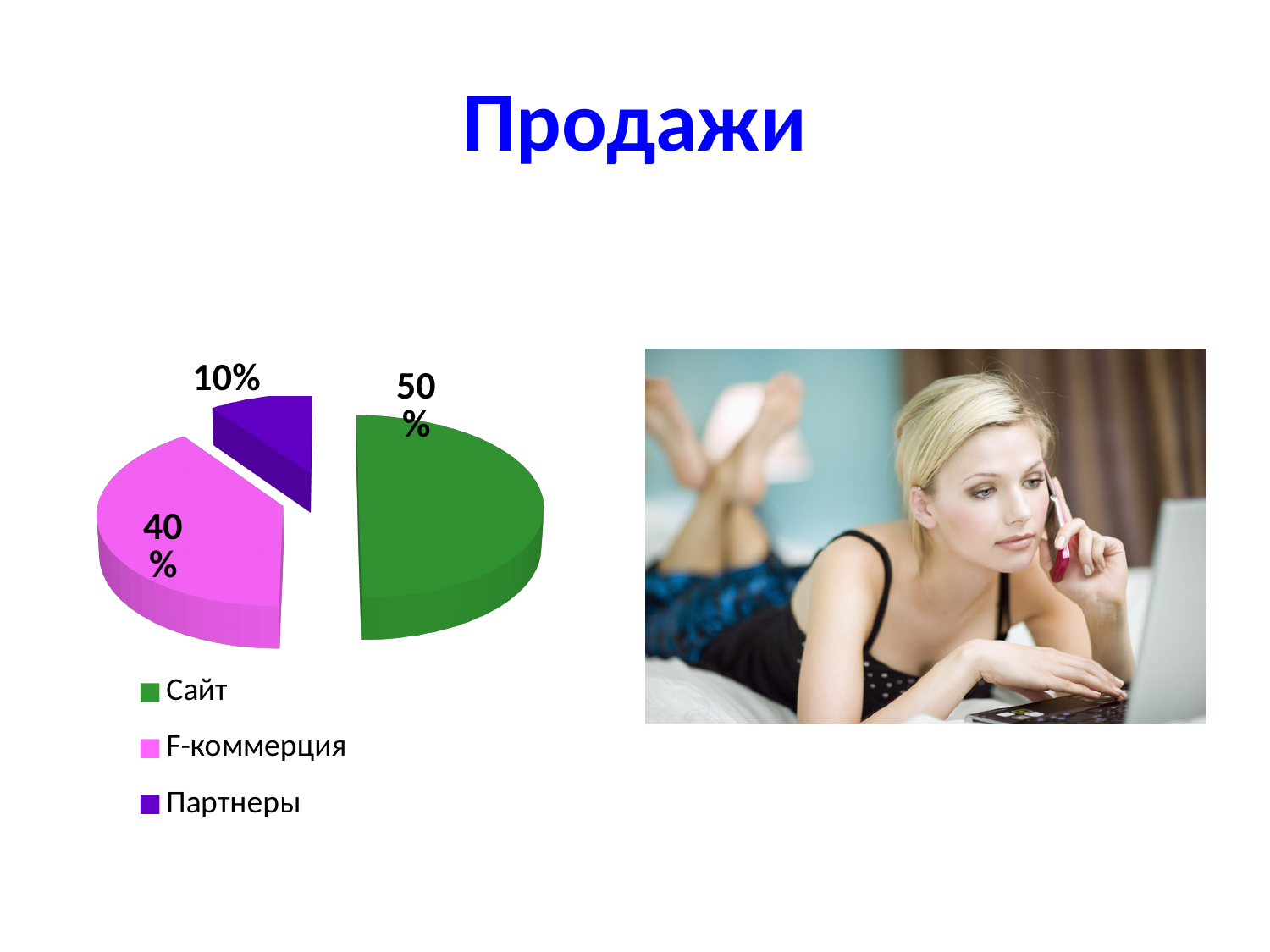
What is the difference between the shares of F-коммерция and Партнеры? 30% What share of the pie does F-коммерция have? 40% Which category has the smallest slice of the pie? Партнеры What colour is the slice for Партнеры? purple How many categories does the pie chart have? 3 Which is larger, the share of F-коммерция or the share of Партнеры? F-коммерция What is the title of the slide containing the chart? Продажи What share of the pie does Партнеры have? 10% What is the difference between the shares of Сайт and F-коммерция? 10% Which category has the largest slice of the pie? Сайт What kind of chart is shown on the slide? pie chart What share of the pie does Сайт have? 50%